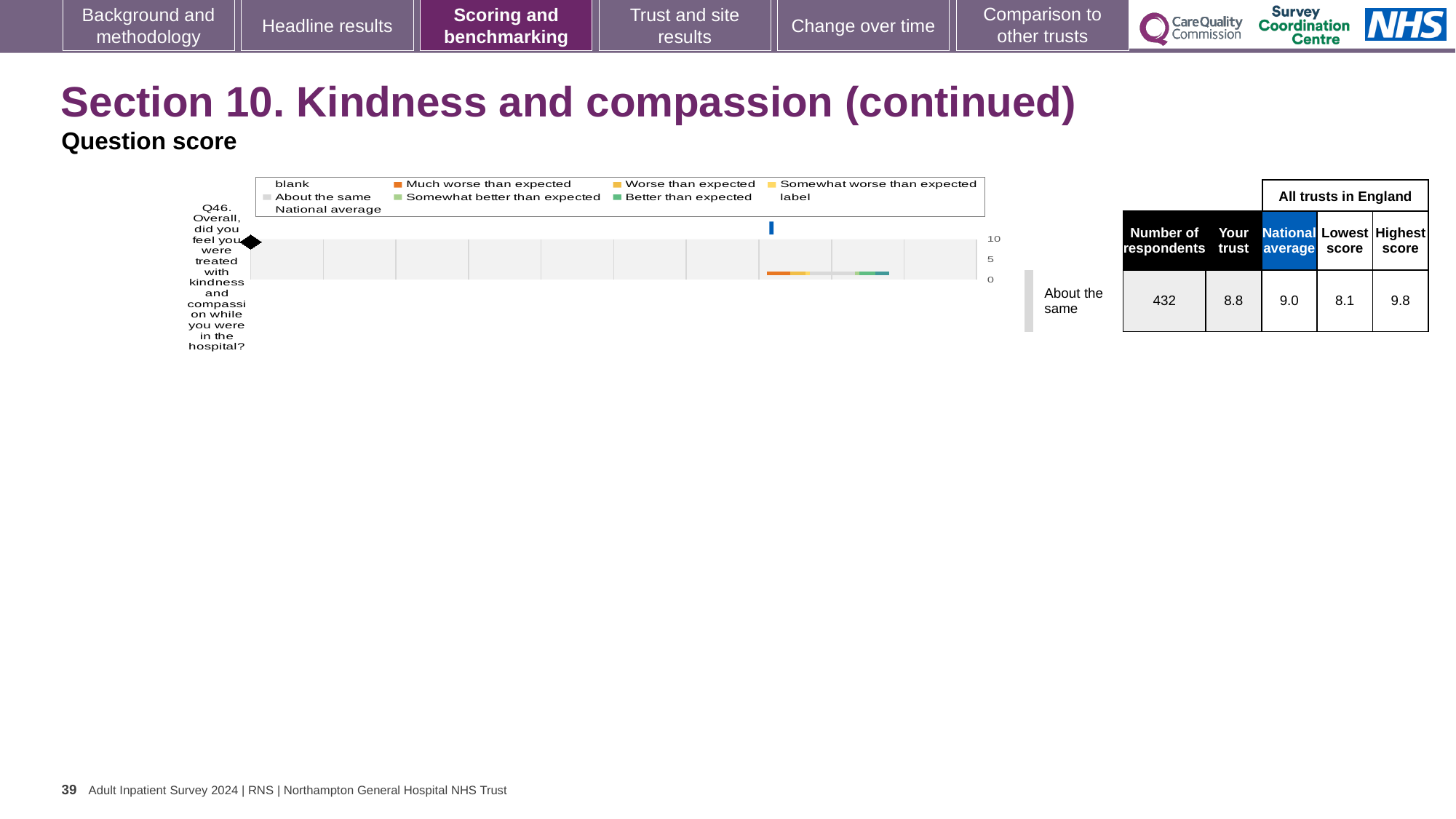
What is the highest score among all trusts in England for Q46? 9.8 How many survey questions are plotted on the chart? 1 Is the national average marker for Q46 plotted at a value greater or less than 5 on the axis? greater What is the difference between the highest score and the lowest score for Q46? 1.7 How many respondents answered Q46? 432 Which benchmark category is the trust's Q46 score placed in? About the same What is the lowest score among all trusts in England for Q46? 8.1 What is the national average score shown for Q46? 9.0 Which is larger for Q46: the trust's score or the national average? National average By how much does the national average exceed the trust's score for Q46? 0.2 What kind of chart is used to show the Q46 question score? Bar chart What is the 'Your trust' score for Q46 (treated with kindness and compassion)? 8.8